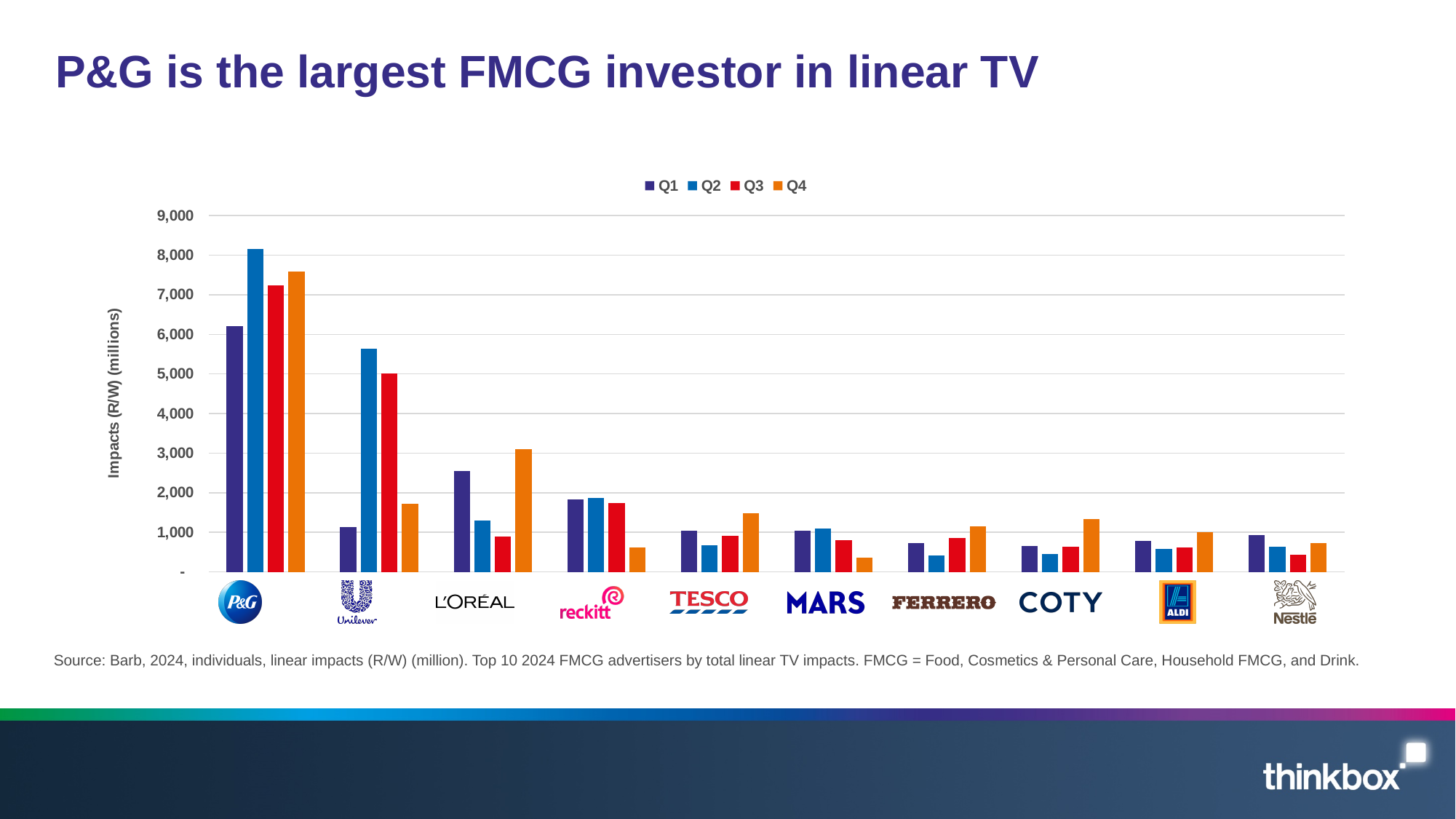
Which quarter has the highest value for P&G? Q2 How many advertisers (brands) are shown along the x axis? 10 For Unilever, which is larger: the Q2 value or the Q3 value? Q2 How many series does the legend list? 4 Is the Q2 value for Unilever greater or less than 5,000? greater Is the Q2 value for P&G greater or less than 8,000? greater Is the Q4 value for Mars greater or less than 1,000? less What kind of chart is shown on the slide? Bar chart Which quarter has the highest value for L'Oréal? Q4 Which quarter has the lowest value for Unilever? Q1